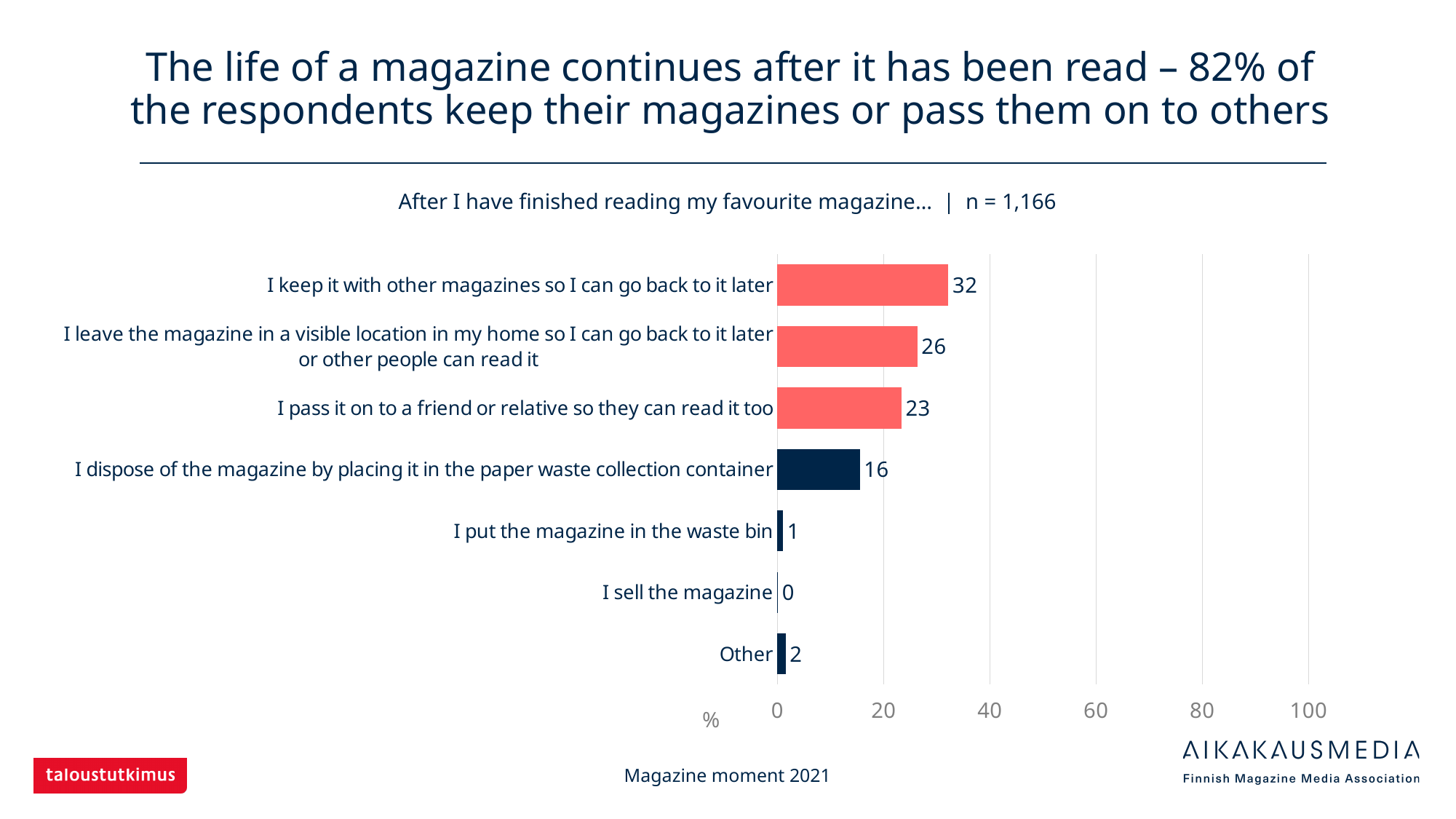
Which response has the lowest value? I sell the magazine Which response has the highest value? I keep it with other magazines so I can go back to it later What value is shown for 'I sell the magazine'? 0 Is the value for 'I keep it with other magazines so I can go back to it later' greater or less than 20? greater How many response categories are shown in the chart? 7 What kind of chart is shown on the slide? Bar chart What is the difference between the values for 'I keep it with other magazines so I can go back to it later' and 'I pass it on to a friend or relative so they can read it too'? 9 What value is shown for 'I pass it on to a friend or relative so they can read it too'? 23 What is the sample size (n) stated above the chart? 1,166 What percentage of respondents keep the magazine with other magazines so they can go back to it later? 32 What value is shown for 'I dispose of the magazine by placing it in the paper waste collection container'? 16 Which is larger: the value for 'I leave the magazine in a visible location in my home' or the value for 'I dispose of the magazine by placing it in the paper waste collection container'? I leave the magazine in a visible location in my home